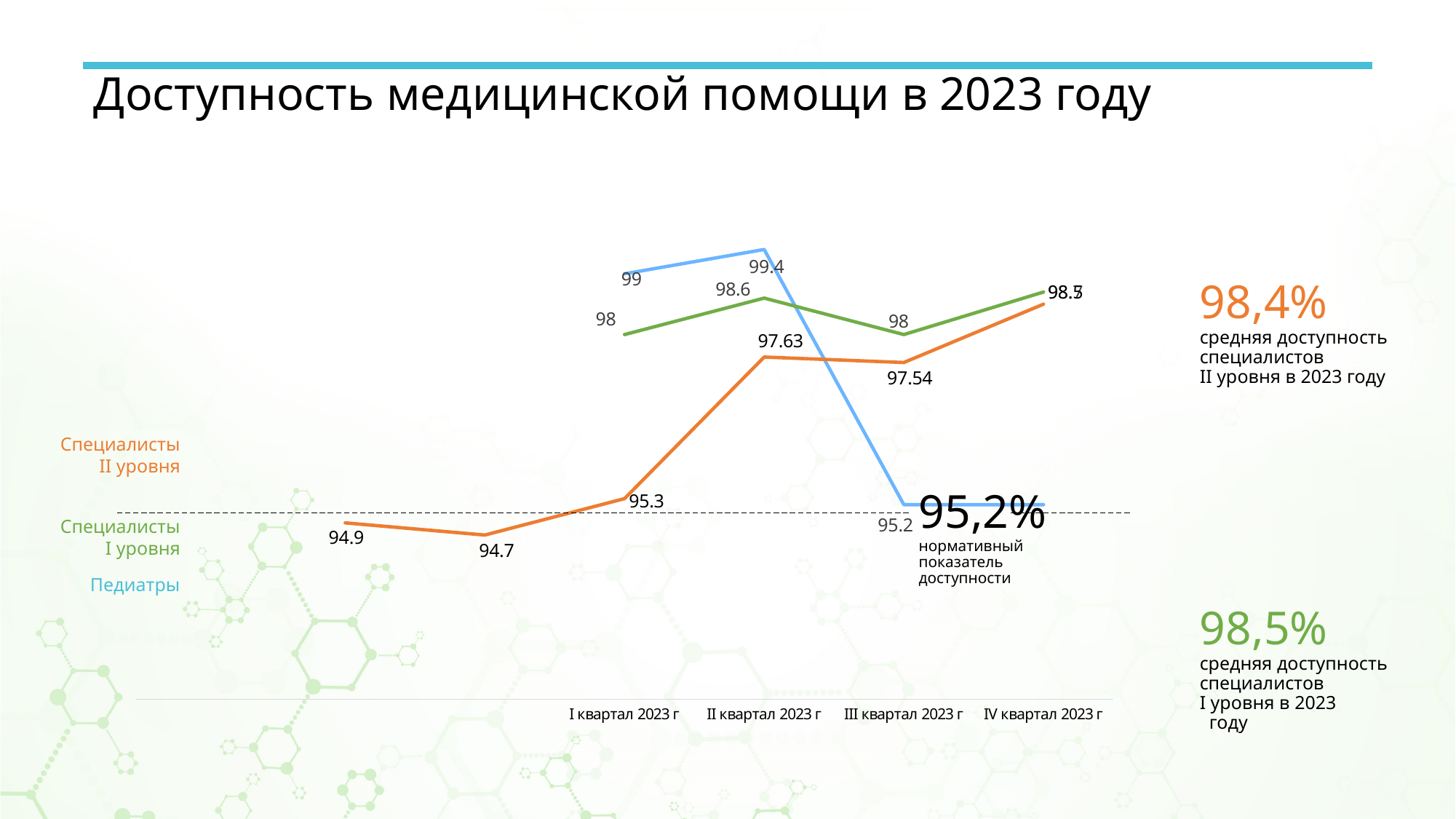
How many series does the chart show? 3 What is the normative availability indicator (нормативный показатель доступности) marked by the dashed line? 95,2% What is the difference between Педиатры and Специалисты I уровня in II квартал 2023 г? 0.8 In III квартал 2023 г, which is higher: Специалисты I уровня or Специалисты II уровня? Специалисты I уровня What is the value for Специалисты I уровня in II квартал 2023 г? 98.6 Does the Педиатры line rise or fall from II квартал 2023 г to III квартал 2023 г? fall What is the value for Специалисты II уровня in III квартал 2023 г? 97.54 What kind of chart is shown on the slide? line chart What is the value for Педиатры in I квартал 2023 г? 99 How many quarters are labelled on the x axis? 4 What is the value for Педиатры in II квартал 2023 г? 99.4 In which quarter is the value for Педиатры highest? II квартал 2023 г